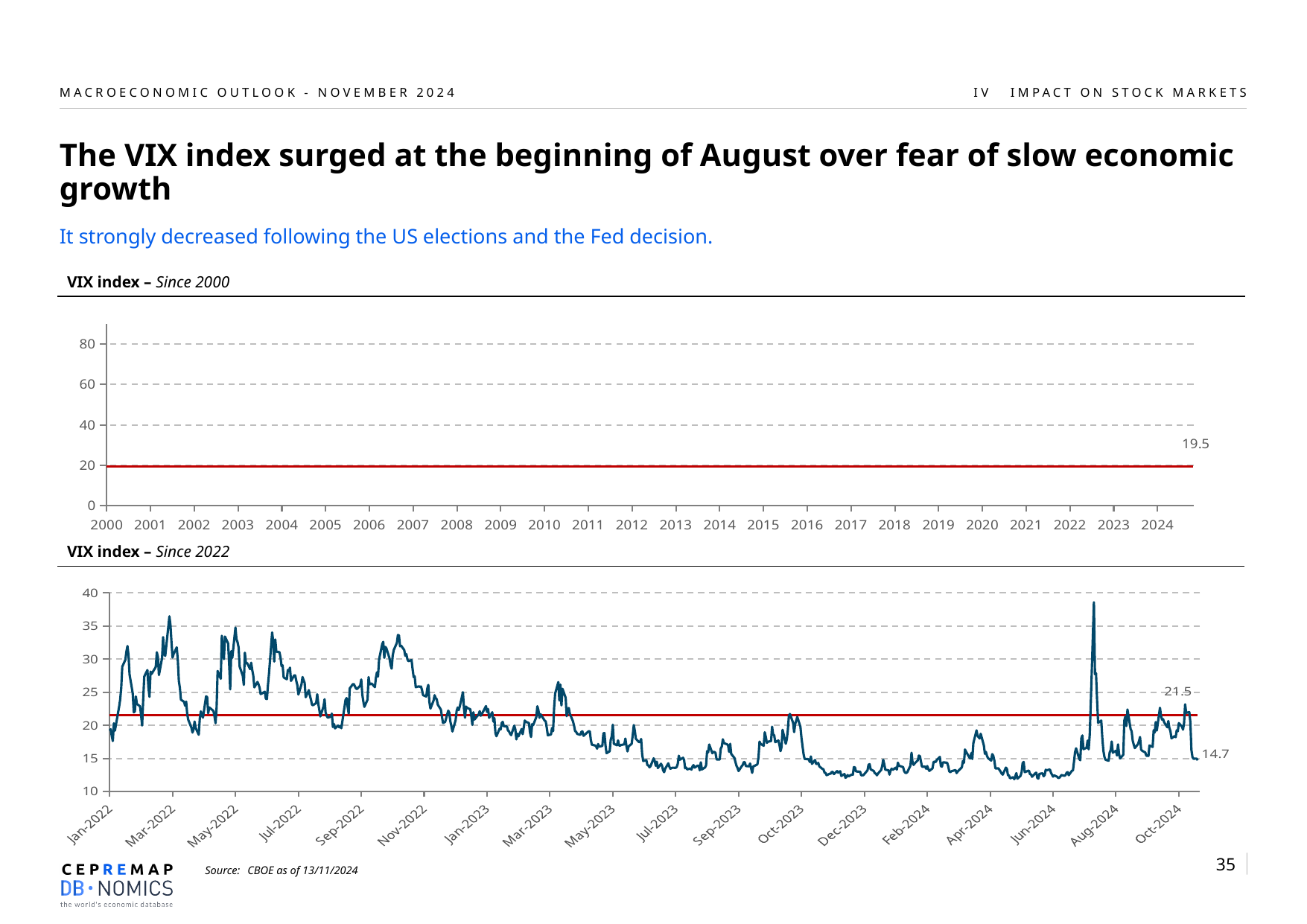
On the 'VIX index – Since 2022' chart, what value is labelled on the red horizontal line? 21.5 On the 'VIX index – Since 2000' chart, what is the highest value shown on the y axis? 80 On the 'VIX index – Since 2022' chart, what is the value labelled at the end of the line in Oct-2024? 14.7 On the 'VIX index – Since 2000' chart, how many year labels are shown on the x axis? 25 On the 'VIX index – Since 2022' chart, which is larger: the latest value 14.7 or the red line value 21.5? 21.5 On the 'VIX index – Since 2000' chart, what value is labelled on the red horizontal line? 19.5 On the 'VIX index – Since 2022' chart, is the peak value in Aug-2024 greater or less than 35? greater What kind of chart is the 'VIX index – Since 2022' chart? line chart On the 'VIX index – Since 2022' chart, what is the difference between the red line value 21.5 and the latest value 14.7? 6.8 On the 'VIX index – Since 2022' chart, is the value around Dec-2023 greater or less than 15? less What source is cited for the charts on the slide? CBOE as of 13/11/2024 On the 'VIX index – Since 2022' chart, is the value around Jun-2024 greater or less than 15? less